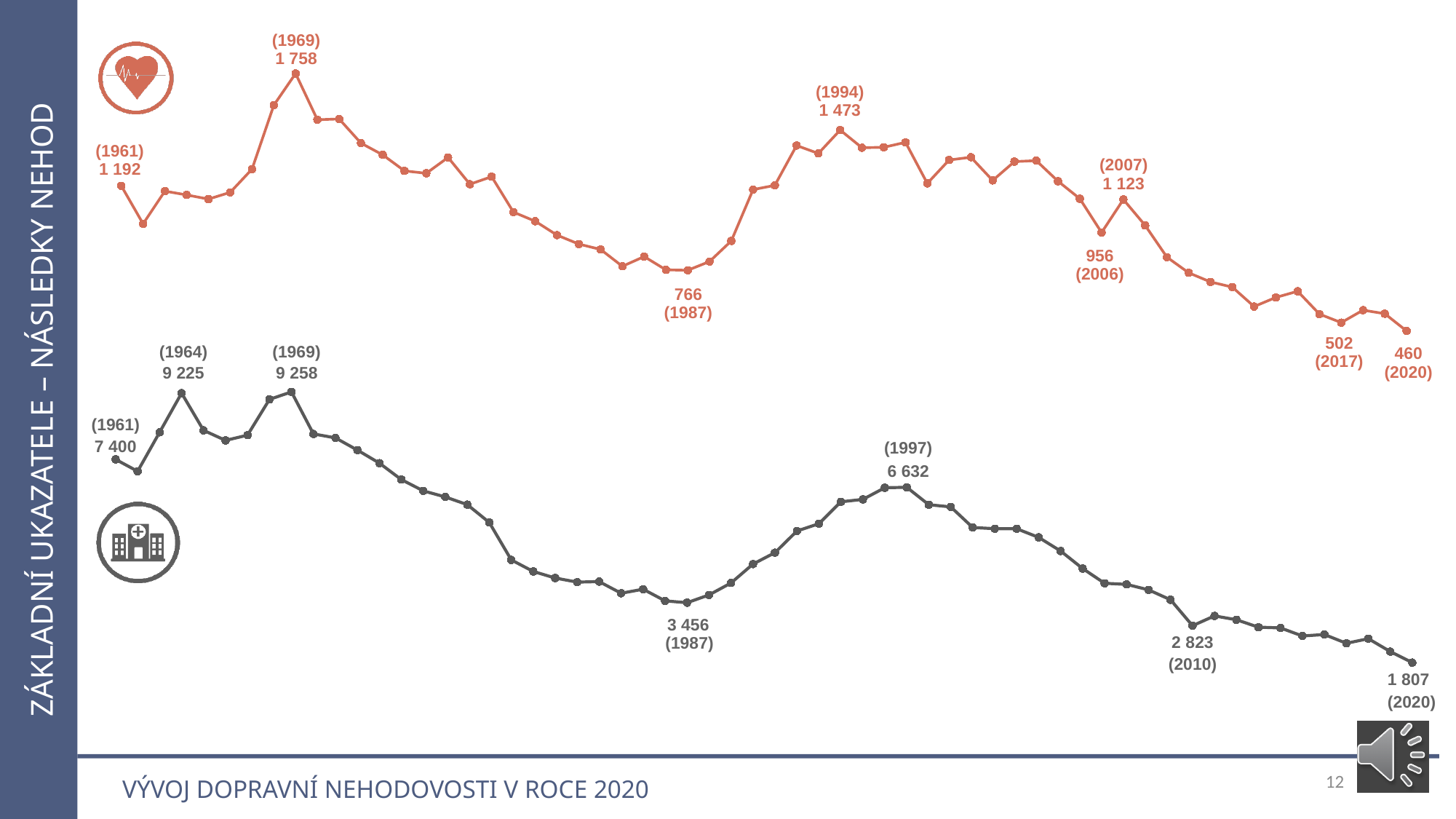
On the upper (orange) line chart, which labelled year has the highest value? 1969 What type of chart is used for both series on the slide? line chart On the lower (grey) line chart, what is the difference between the 1969 value (9 258) and the 1964 value (9 225)? 33 On the upper (orange) line chart, what is the difference between the 2017 value (502) and the 2020 value (460)? 42 On the upper (orange) line chart, which is larger: the value for 1994 or the value for 2007? 1994 On the upper (orange) line chart, do the values rise or fall between 2007 and 2020? fall On the lower (grey) line chart, which is larger: the value for 1987 or the value for 2010? 1987 On the upper (orange) line chart, what value is labelled for 2020? 460 On the lower (grey) line chart, what value is labelled for 1961? 7 400 On the upper (orange) line chart, what value is labelled for 1969? 1 758 On the lower (grey) line chart, which labelled year has the lowest value? 2020 On the lower (grey) line chart, what value is labelled for 1997? 6 632